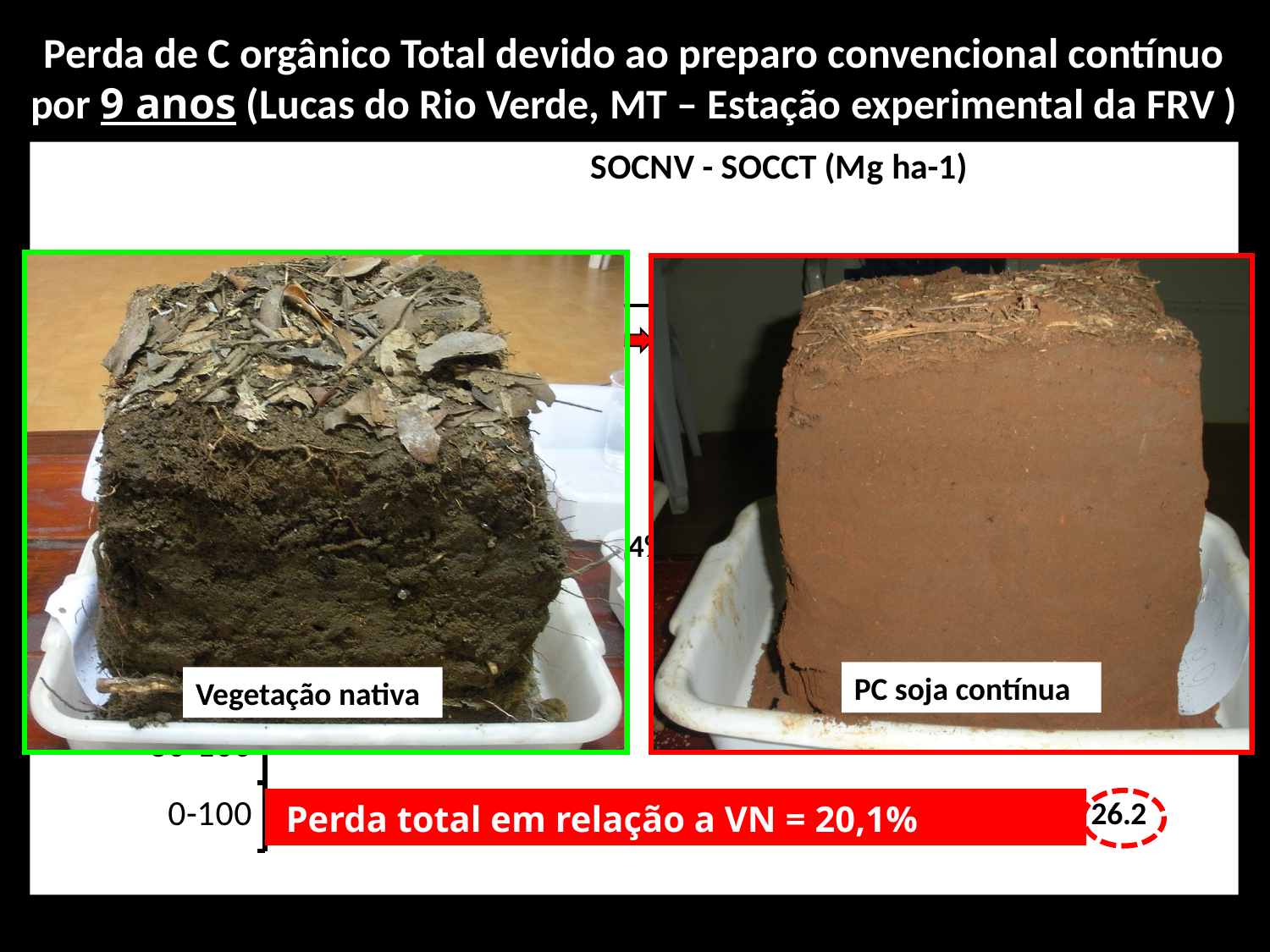
What is the title of the chart on the slide? SOCNV - SOCCT (Mg ha-1) What is the value shown for the 0-100 category in the chart? 26.2 What kind of chart is shown on the slide? bar chart What colour is the bar for the 0-100 category? red